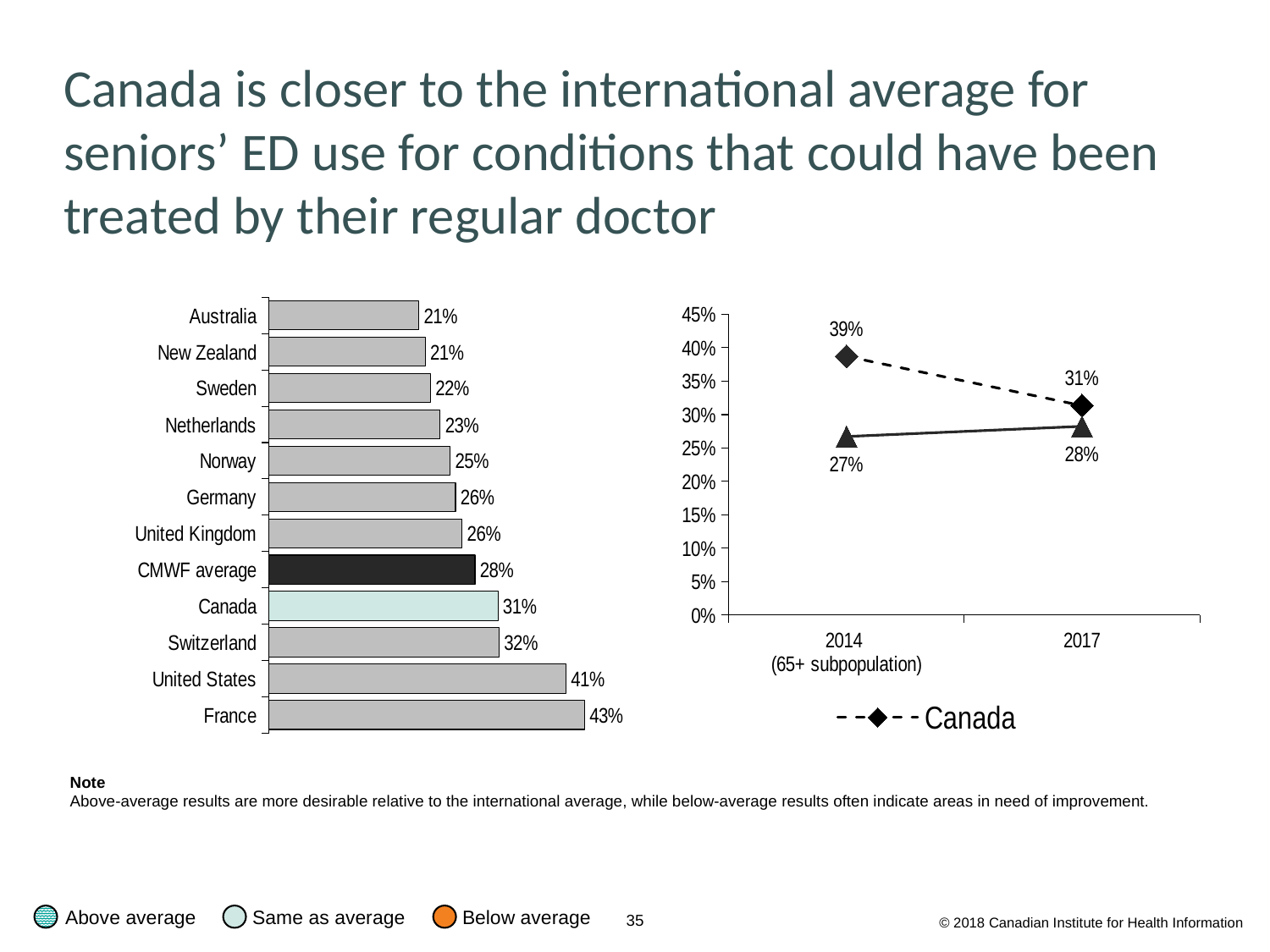
In the right line chart, what is the value for Canada in 2014? 39% In the left bar chart, what is the value for Canada? 31% In the left bar chart, which is larger, the value for Switzerland or the value for Norway? Switzerland In the right line chart, what is the difference between Canada's 2014 and 2017 values? 8% How many categories are shown in the left bar chart? 12 What kind of chart is on the left side of the slide? Bar chart In the right line chart, does the Canada line rise or fall from 2014 to 2017? Fall In the left bar chart, what is the value for the CMWF average? 28% In the left bar chart, what is the difference between the United States and Canada? 10% In the left bar chart, which country has the highest value? France In the right line chart, what is the value for Canada in 2017? 31% In the left bar chart, what is the value for France? 43%